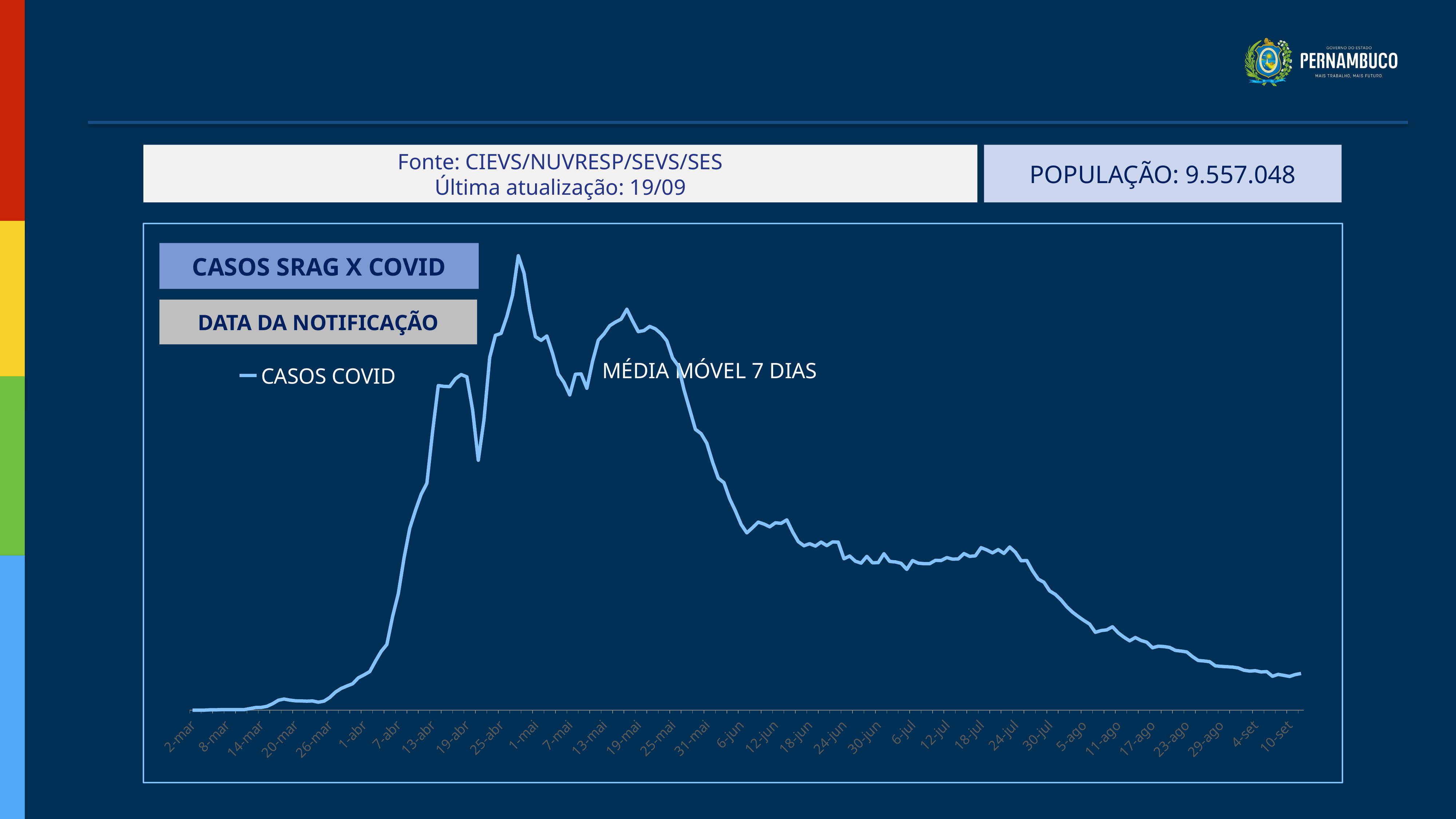
Which is higher, the value at 2-mar or the value at 10-set? 10-set Which is higher, the value at 19-mai or the value at 18-jul? 19-mai What is the name of the series shown in the chart legend? CASOS COVID Does the line rise or fall between 2-mar and 13-abr? rise What is the last date label on the x axis? 10-set What kind of chart is shown on the slide? line chart How many date labels are shown on the x axis? 33 What is the first date label on the x axis? 2-mar How many series does the chart legend list? 1 Does the line rise or fall between 24-jul and 10-set? fall Which is higher, the value at 1-mai or the value at 10-set? 1-mai What is the title shown above the chart? CASOS SRAG X COVID